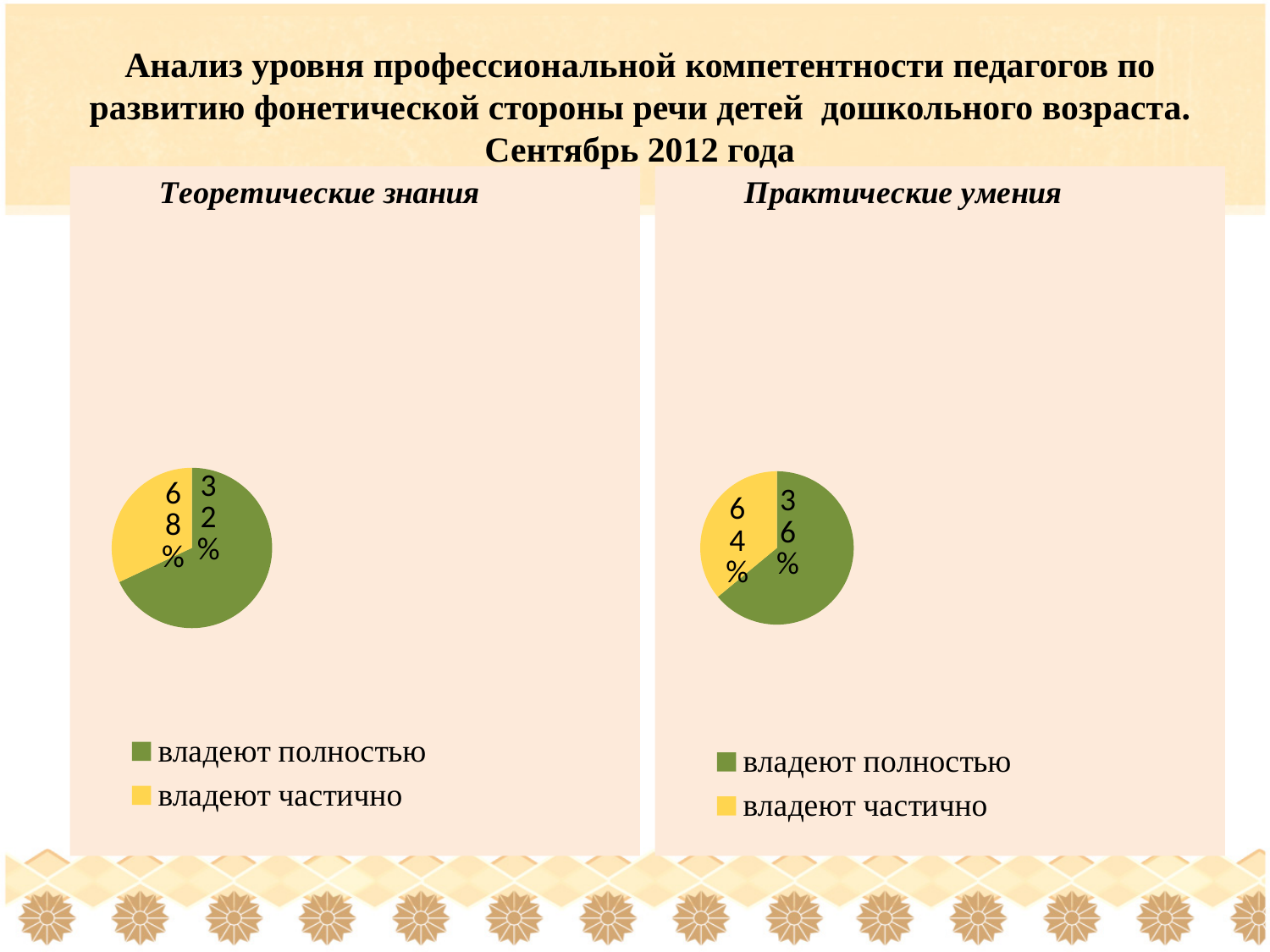
What type of chart is used on the slide for "Теоретические знания"? pie chart In the "Практические умения" chart, what percentage is labelled for "владеют полностью"? 64% In the "Теоретические знания" chart, what is the difference between the two labelled percentages? 36% In the "Практические умения" chart, what is the difference between the two labelled percentages? 28% In the "Практические умения" chart, which colour represents "владеют частично"? yellow How many pie charts are shown on the slide? 2 How many slices does the "Теоретические знания" pie chart have? 2 In the "Практические умения" chart, what percentage is labelled for "владеют частично"? 36% In the "Теоретические знания" chart, what percentage is labelled for "владеют частично"? 32% How many entries does the legend of the "Практические умения" chart list? 2 What is the title of the chart on the left side of the slide? Теоретические знания In the "Теоретические знания" chart, what percentage is labelled for "владеют полностью"? 68%